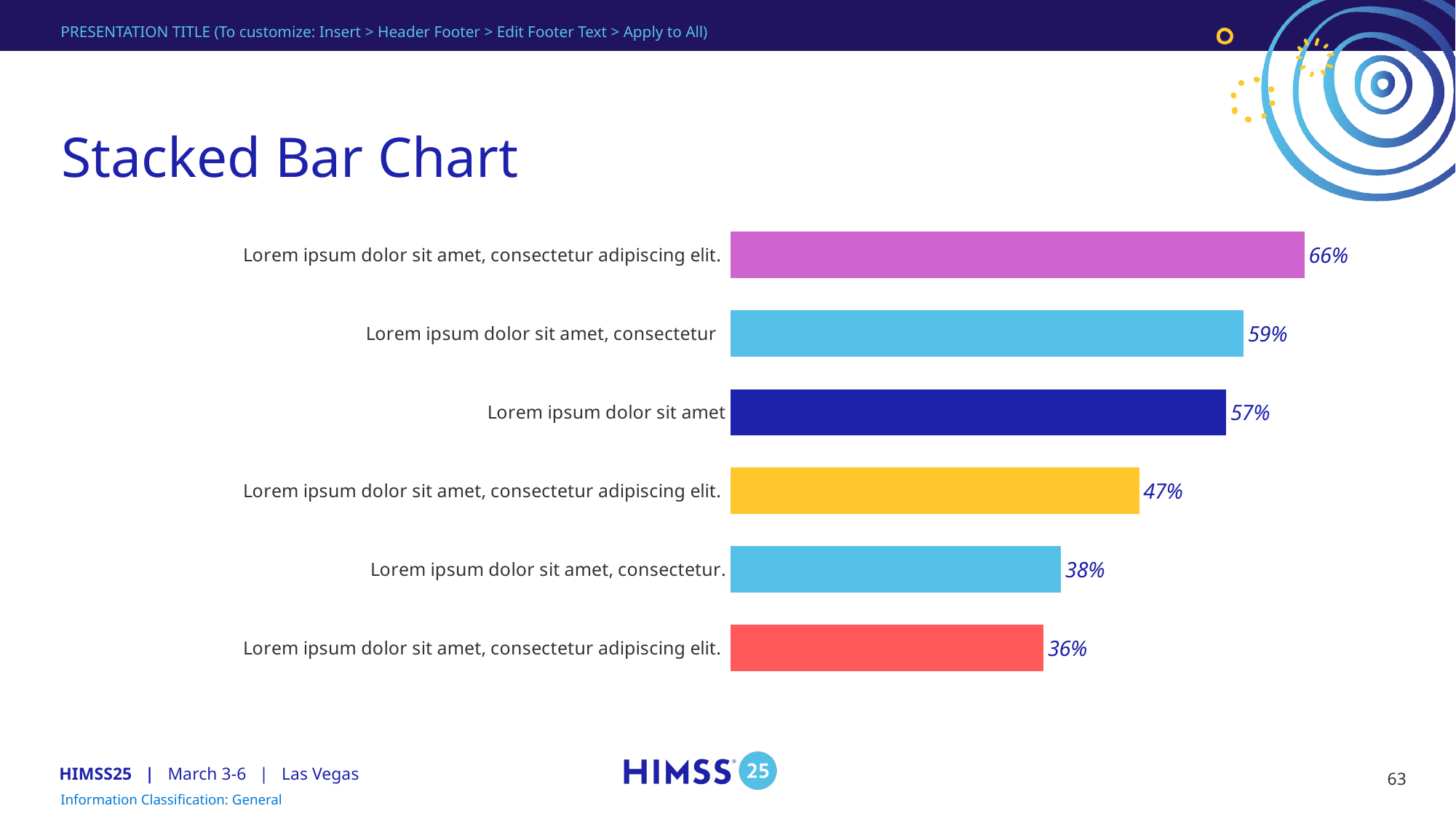
Which is larger, the value of the yellow bar or the value of the fifth (light blue) bar? The yellow bar (47%) What value is shown for the top bar of the chart? 66% What value is shown for the dark blue bar in the chart? 57% Which bar has the lowest value in the chart? The bottom (red) bar, 36% What is the difference between the top bar's value and the bottom bar's value? 30% What type of chart is shown on the slide? Bar chart Which bar has the highest value in the chart? The top (purple) bar, 66% What value is shown for the yellow bar in the chart? 47% What is the difference between the second bar (59%) and the third bar (57%)? 2% How many bars are plotted in the chart? 6 What is the title of the slide containing the chart? Stacked Bar Chart What value is shown for the bottom (red) bar of the chart? 36%